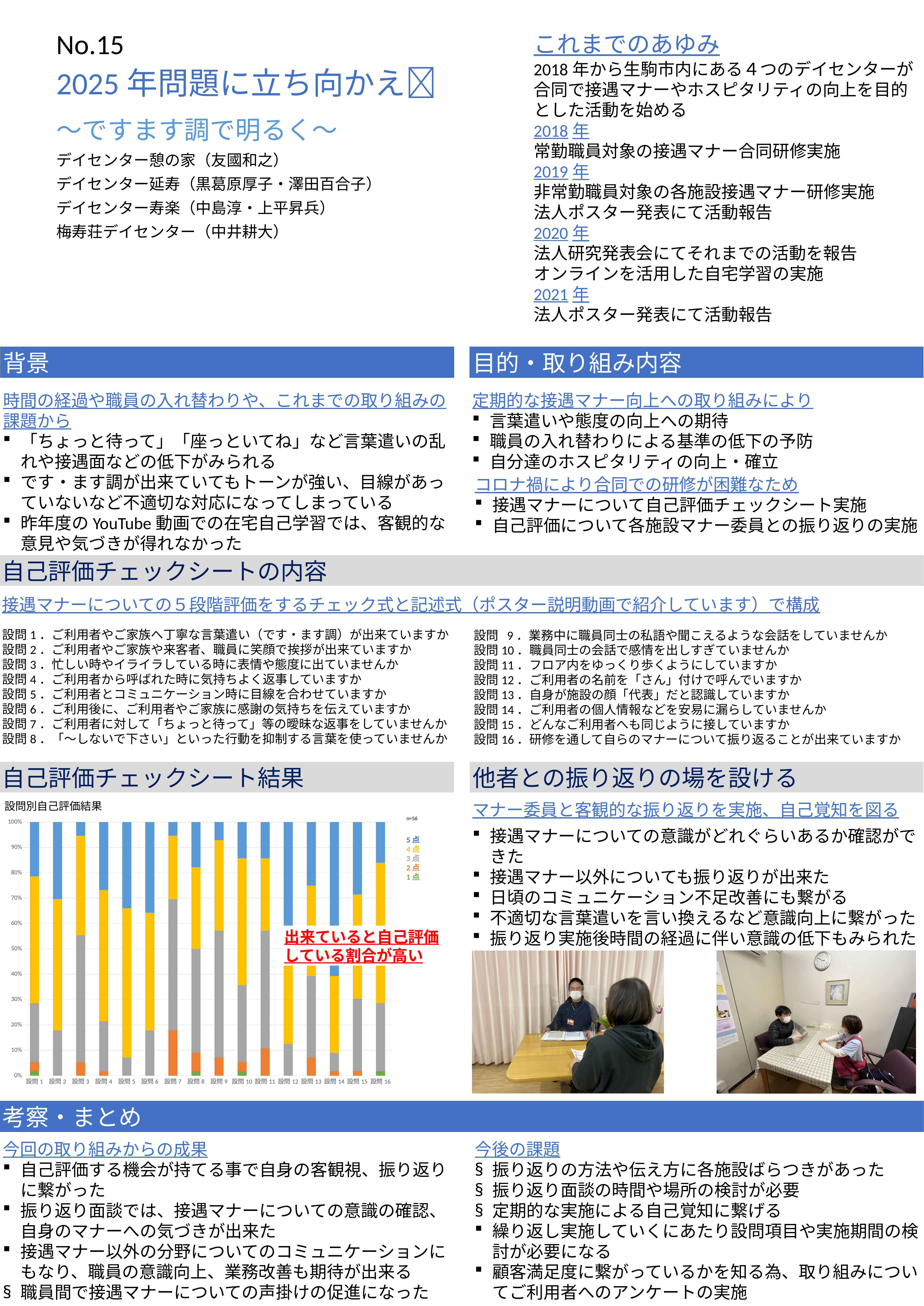
What kind of chart is shown under 自己評価チェックシート結果? bar chart What sample size (n) is noted on the chart? n=56 Is the 2点 share for 設問 7 greater or less than 10%? greater Is the 5点 share for 設問 3 greater or less than 10%? less Which has the larger 2点 share, 設問 7 or 設問 2? 設問 7 Is the 5点 share for 設問 5 greater or less than 30%? greater How many 設問 categories are plotted along the x axis of the chart? 16 How many series does the chart's legend list? 5 What is the title of the chart? 設問別自己評価結果 Which has the larger 5点 share, 設問 5 or 設問 3? 設問 5